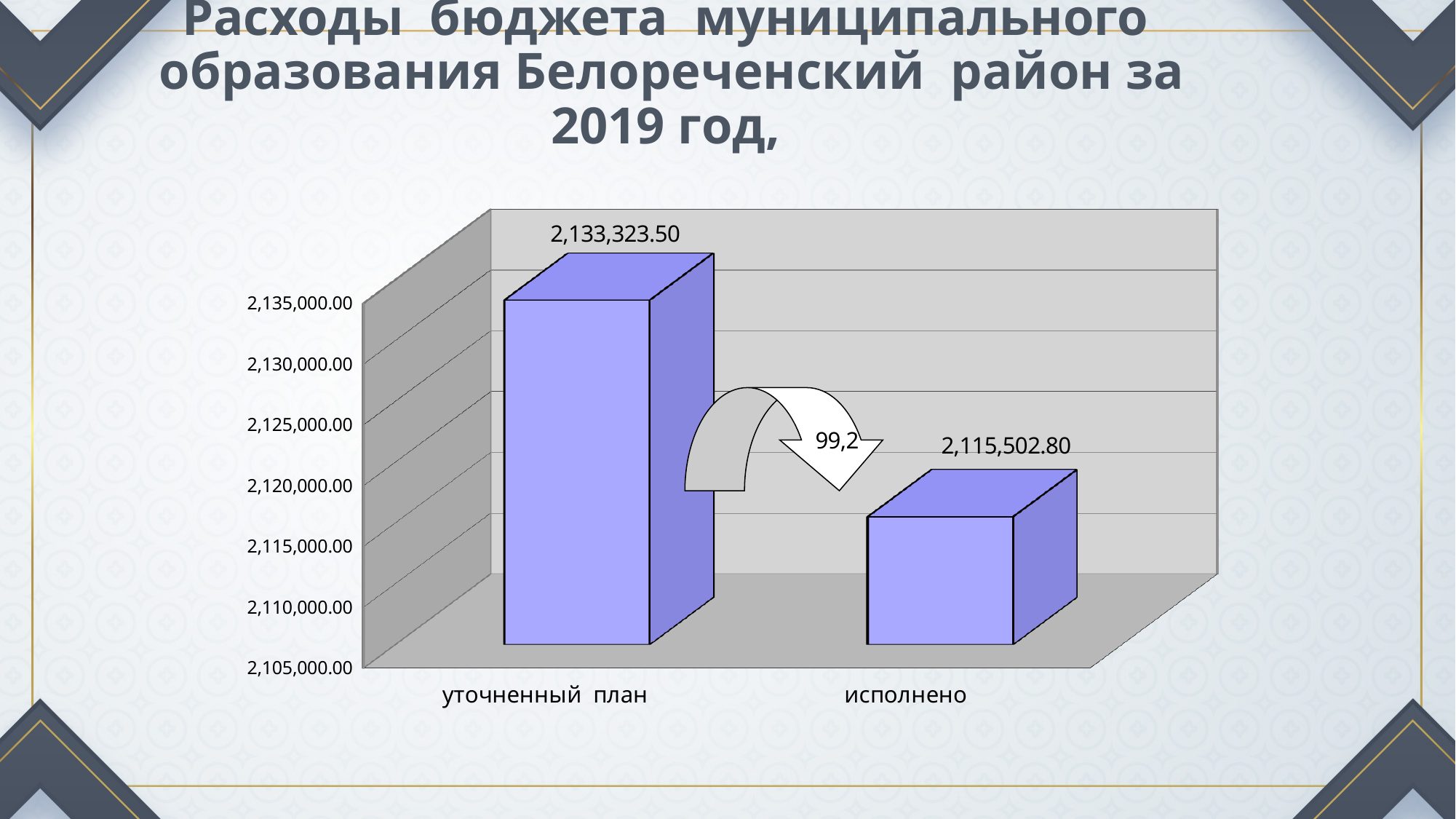
How many categories are shown on the x axis? 2 What kind of chart is shown on the slide? bar chart Which category has the lowest value? исполнено Is the value for "уточненный план" greater or less than 2,130,000.00? greater What is the value for "исполнено"? 2,115,502.80 Which is larger, the value for "уточненный план" or the value for "исполнено"? уточненный план Which category has the highest value? уточненный план What is the value for "уточненный план"? 2,133,323.50 Is the value for "исполнено" greater or less than 2,120,000.00? less Do the values rise or fall from "уточненный план" to "исполнено"? fall What number is printed on the arrow between the two bars? 99,2 What is the difference between the values for "уточненный план" and "исполнено"? 17,820.70